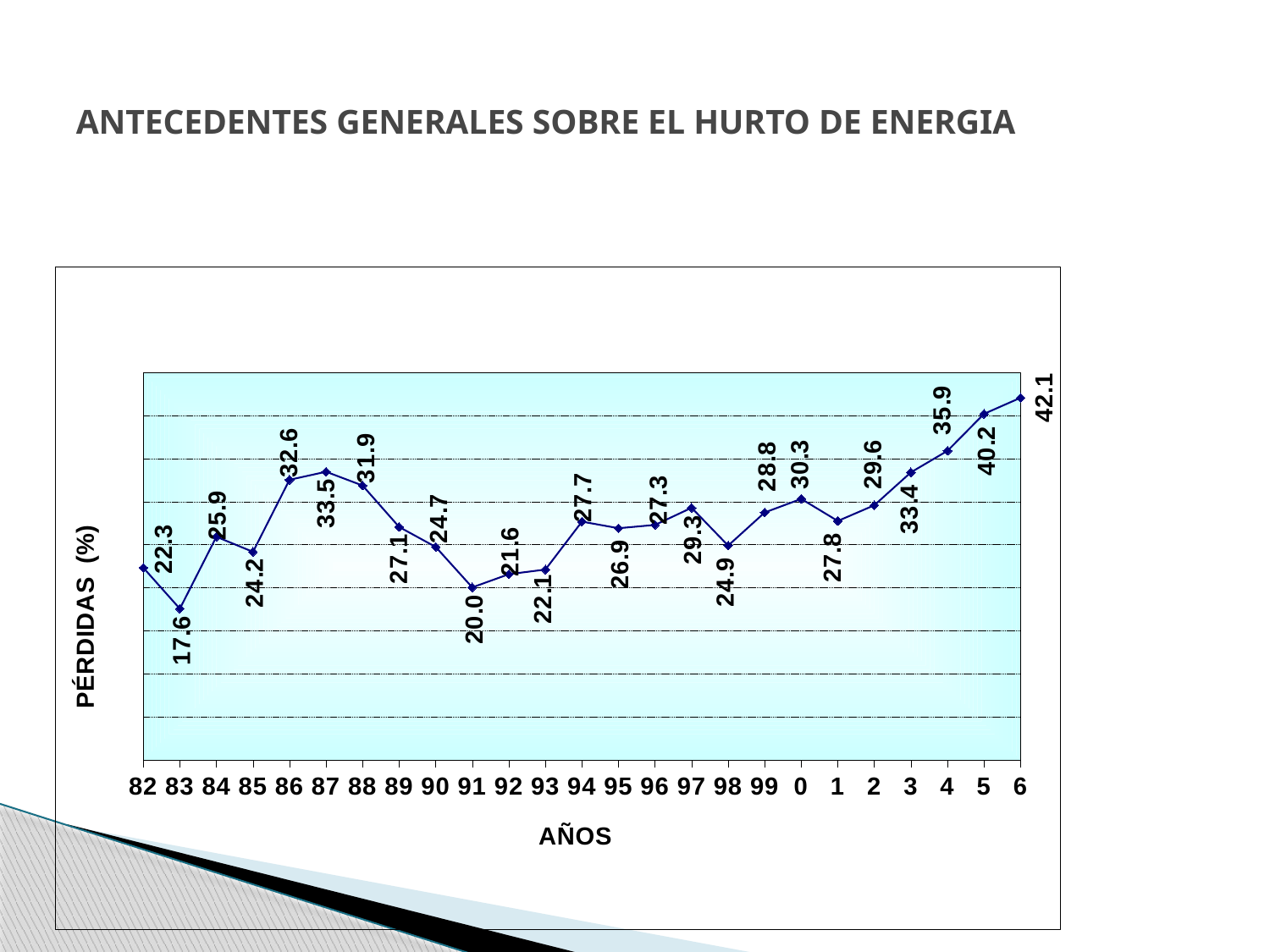
What is the value of PÉRDIDAS (%) for year 0? 30.3 How many data points are plotted on the chart? 25 What type of chart is shown on the slide? Line chart Which year has a larger value, 94 or 98? 94 Which year has the highest value of PÉRDIDAS (%)? 6 Which year has the lowest value of PÉRDIDAS (%)? 83 What is the value of PÉRDIDAS (%) for year 83? 17.6 Do the values rise or fall from year 1 to year 6? Rise What is the difference between the values for year 6 and year 5? 1.9 What is the value of PÉRDIDAS (%) for year 91? 20.0 What is the value of PÉRDIDAS (%) for year 87? 33.5 What is the difference between the values for year 86 and year 85? 8.4